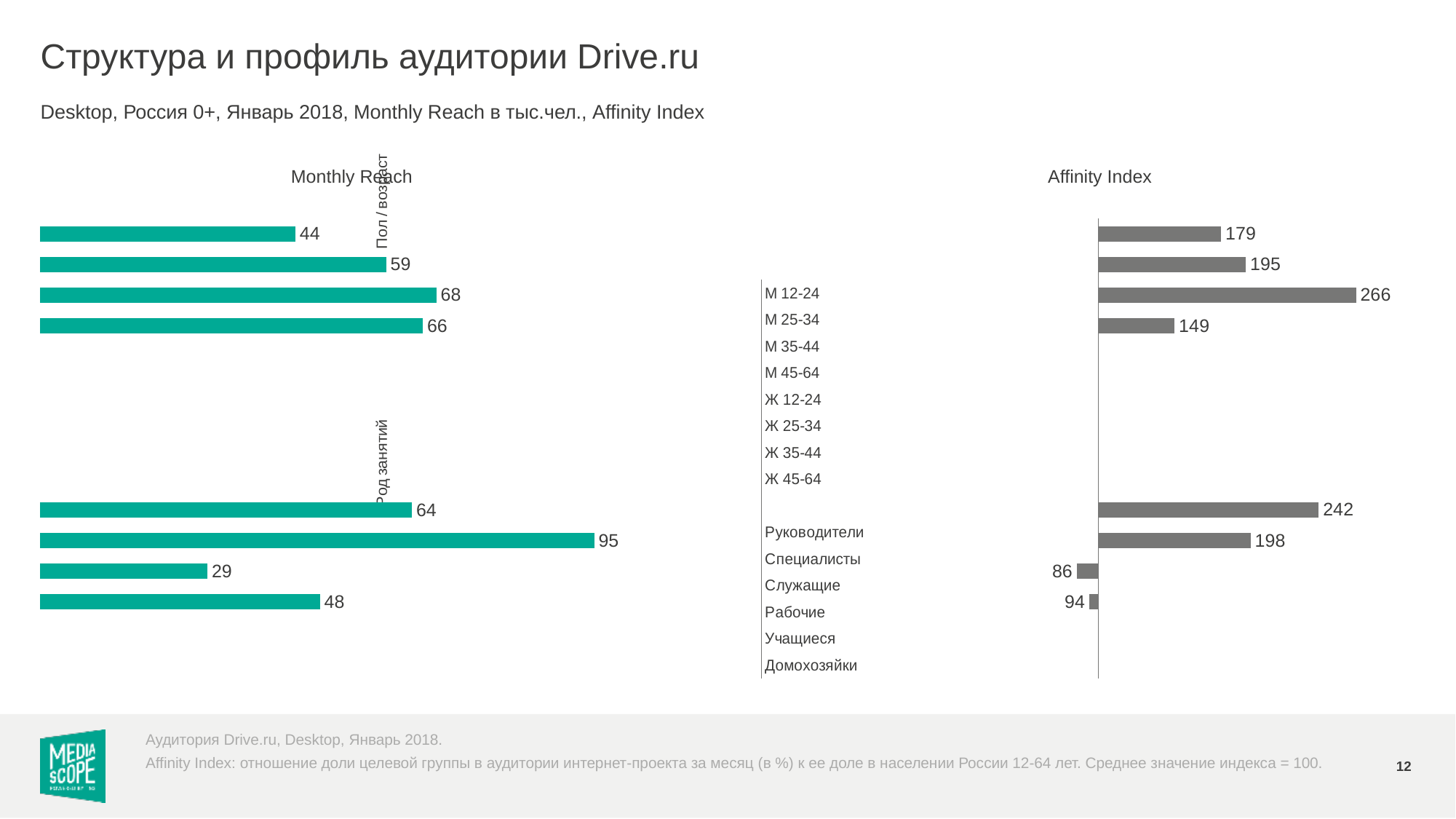
In the Monthly Reach chart, what is the highest value shown? 95 In the Monthly Reach chart, what is the value of the topmost bar? 44 In the Affinity Index chart, what is the highest value shown? 266 In the Monthly Reach chart, what is the lowest value shown? 29 In the Monthly Reach chart, which is larger: the second bar from the top (59) or the third bar from the top (68)? the third bar (68) In the Affinity Index chart, what is the value of the topmost bar? 179 In the Affinity Index chart, what is the lowest value shown? 86 How many bars are plotted in the Affinity Index chart? 8 How many bars are plotted in the Monthly Reach chart? 8 In the Affinity Index chart, what is the difference between the highest value (266) and the lowest value (86)? 180 What kind of chart is the Monthly Reach chart on the left? bar chart What colour are the bars in the Monthly Reach chart? teal green